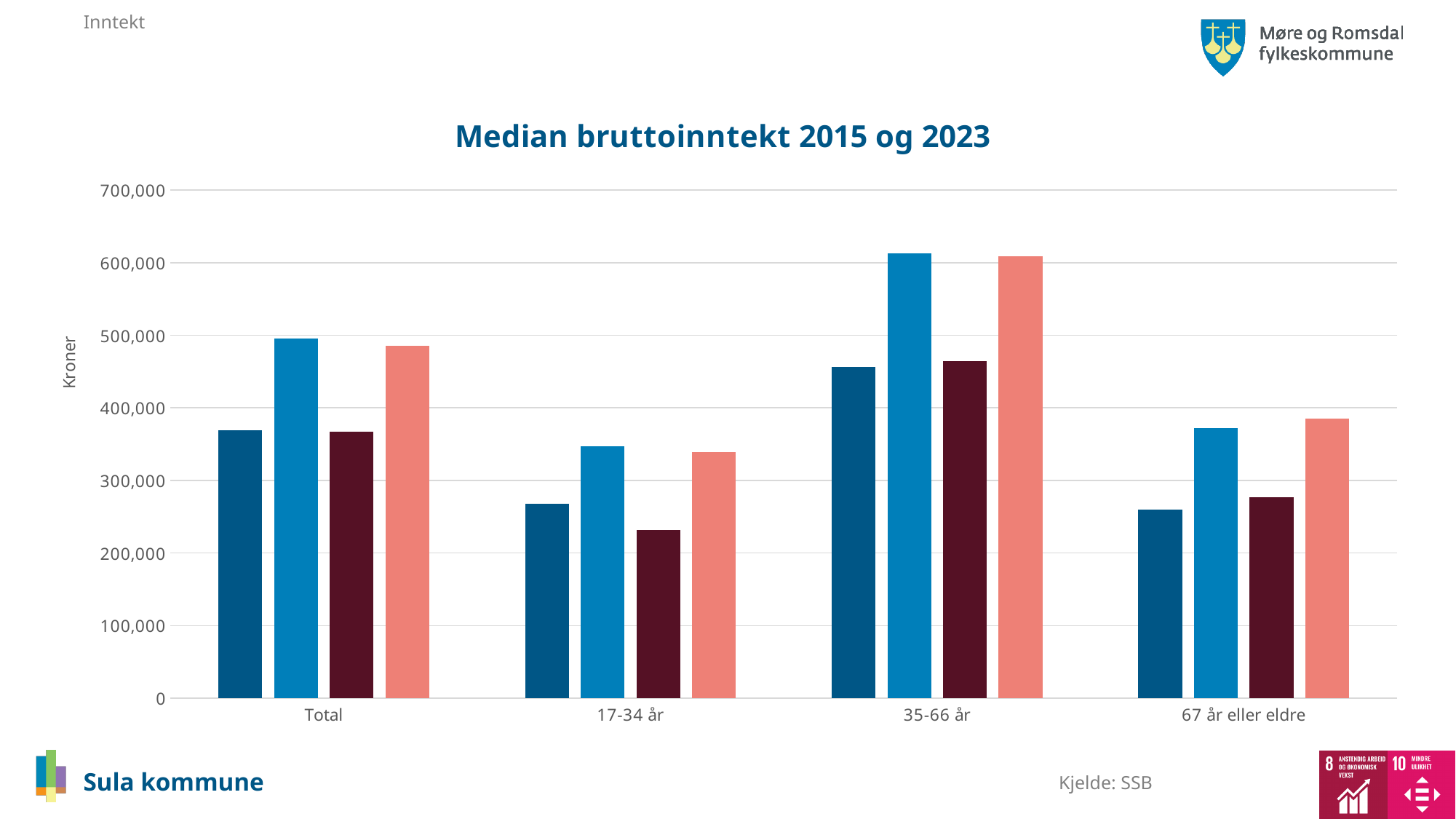
Is the value of the dark blue bar for 67 år eller eldre greater or less than 300,000? less How many bars are plotted for each category? 4 Which is larger: the dark red bar for 17-34 år or the dark red bar for 67 år eller eldre? 67 år eller eldre What is the title of the chart? Median bruttoinntekt 2015 og 2023 Is the value of the dark blue bar for Total greater or less than 400,000? less Which category has the tallest bar in the chart? 35-66 år Is the value of the light blue bar for 35-66 år greater or less than 600,000? greater What kind of chart is shown on the slide? bar chart How many categories are shown on the x axis? 4 What is the label of the y axis? Kroner